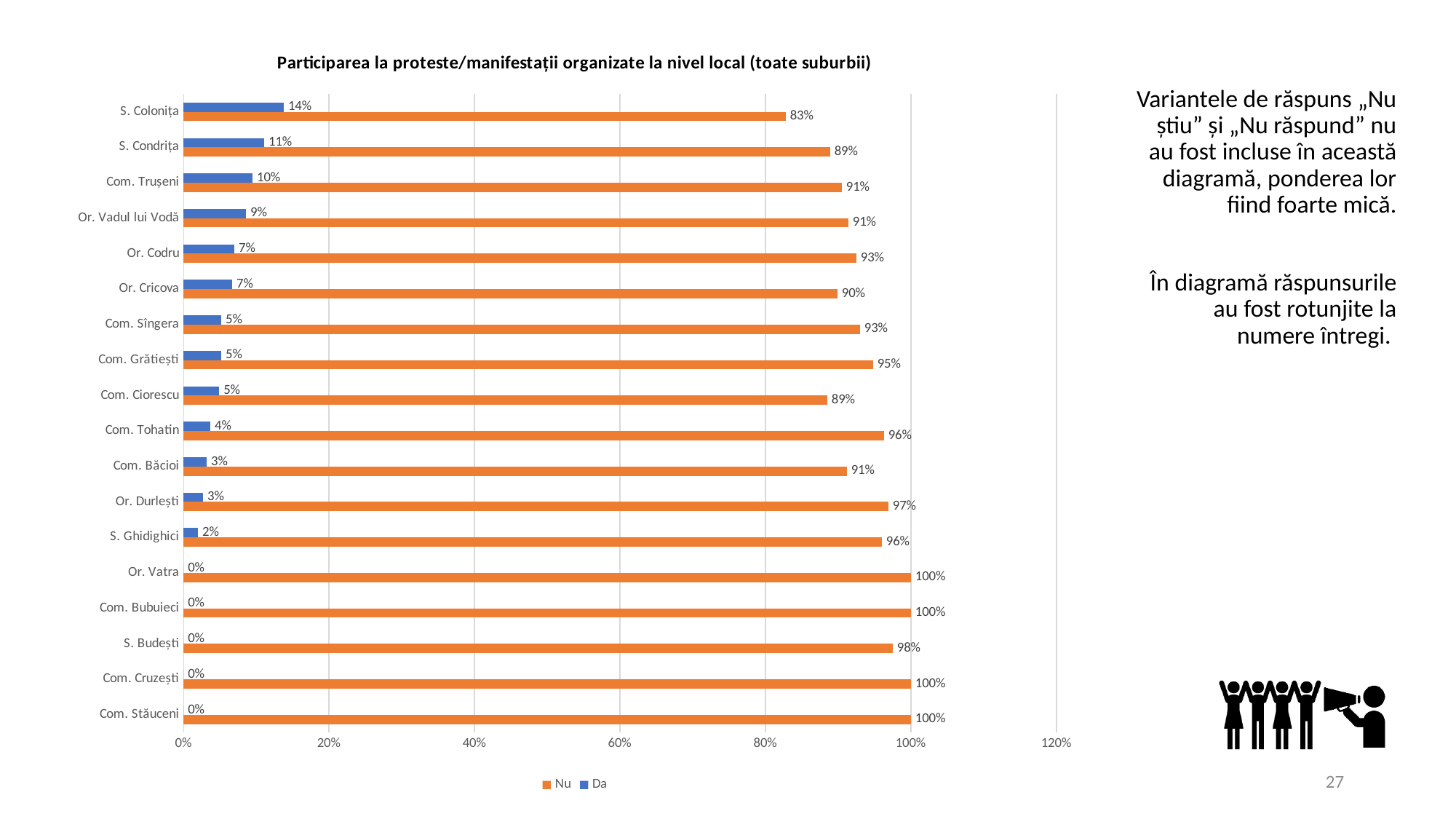
Which is larger: the "Da" value for S. Condrița or the "Da" value for Com. Trușeni? S. Condrița Which category has the highest "Da" value? S. Colonița How many series does the legend list? 2 What kind of chart is shown on the slide? Bar chart What is the value of the "Da" series for S. Colonița? 14% What is the difference between the "Nu" values for Com. Tohatin and S. Colonița? 13% What is the value of the "Nu" series for Com. Ciorescu? 89% What is the combined total of the "Da" and "Nu" values for S. Colonița? 97% How many categories (suburbs) are shown on the chart? 18 What is the title of the chart? Participarea la proteste/manifestații organizate la nivel local (toate suburbii) Which category has the lowest "Nu" value? S. Colonița What is the value of the "Nu" series for Or. Durlești? 97%